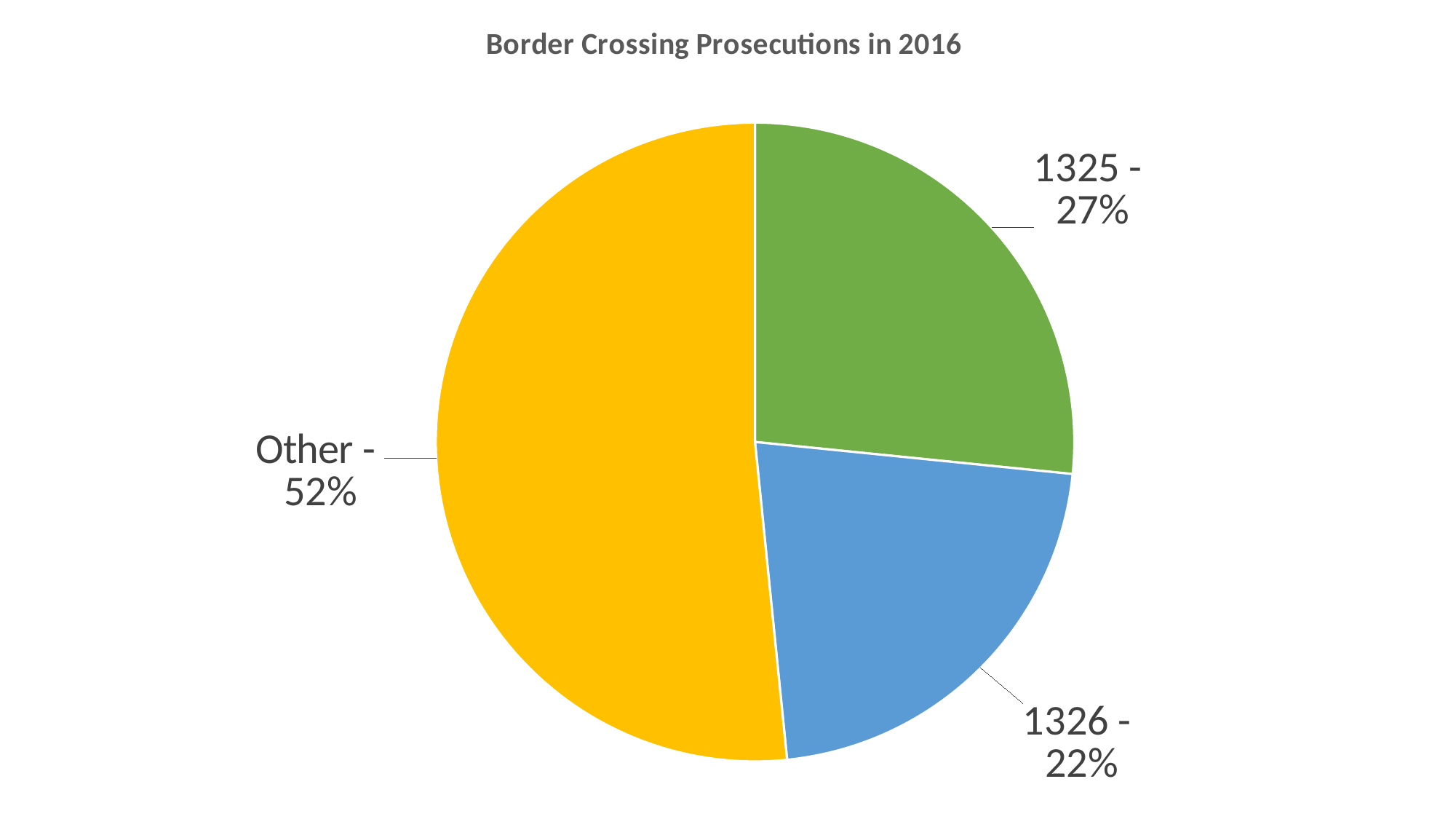
What share of the pie does the '1325' slice represent? 27% Which category has the largest share of the pie? Other What colour is the 'Other' slice? yellow What share of the pie does the 'Other' slice represent? 52% What kind of chart is shown on the slide? pie chart How many slices does the pie chart have? 3 What share of the pie does the '1326' slice represent? 22% Which is larger, the share for 1325 or the share for 1326? 1325 What is the difference in percentage points between the '1325' slice and the '1326' slice? 5 What is the difference in percentage points between the 'Other' slice and the '1325' slice? 25 Which category has the smallest share of the pie? 1326 What is the title of the chart? Border Crossing Prosecutions in 2016